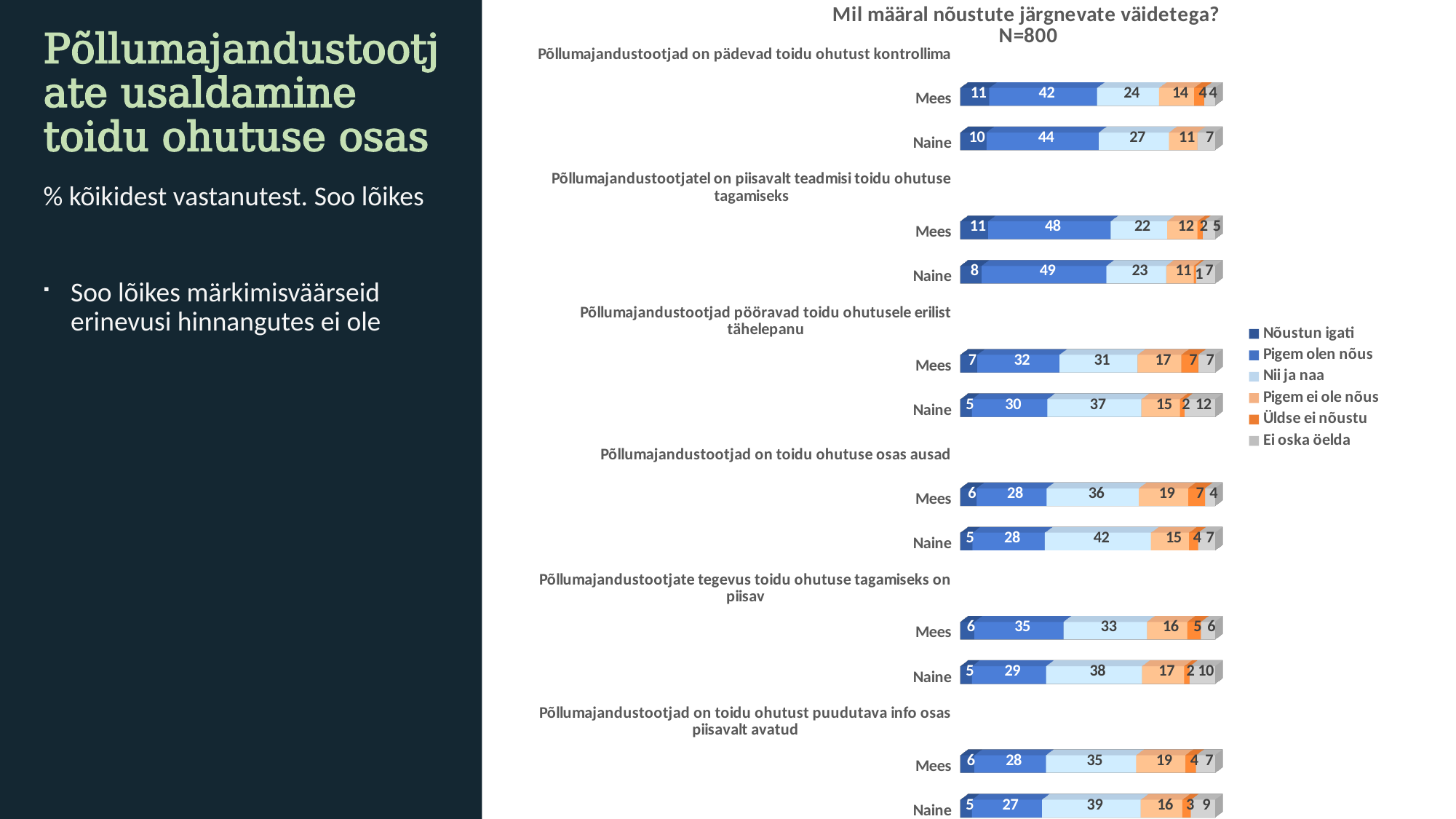
Which bar has the highest 'Pigem olen nõus' value? Naine, Põllumajandustootjatel on piisavalt teadmisi toidu ohutuse tagamiseks How many bars are plotted in the chart? 12 What is the 'Pigem olen nõus' value for Mees on the statement 'Põllumajandustootjad on pädevad toidu ohutust kontrollima'? 42 How many series does the legend list? 6 What is the 'Nii ja naa' value for Naine on the statement 'Põllumajandustootjad on toidu ohutuse osas ausad'? 42 What is the 'Ei oska öelda' value for Naine on the statement 'Põllumajandustootjad pööravad toidu ohutusele erilist tähelepanu'? 12 On the statement 'Põllumajandustootjad pööravad toidu ohutusele erilist tähelepanu', which has the larger 'Nii ja naa' value, Mees or Naine? Naine On the statement 'Põllumajandustootjate tegevus toidu ohutuse tagamiseks on piisav', what is the difference between the 'Pigem olen nõus' values for Mees and Naine? 6 What sample size (N) is shown in the chart title? N=800 What is the 'Pigem ei ole nõus' value for Mees on the statement 'Põllumajandustootjad on toidu ohutust puudutava info osas piisavalt avatud'? 19 What kind of chart is shown on the slide? stacked bar chart What is the total of the Mees bar for the statement 'Põllumajandustootjatel on piisavalt teadmisi toidu ohutuse tagamiseks'? 100